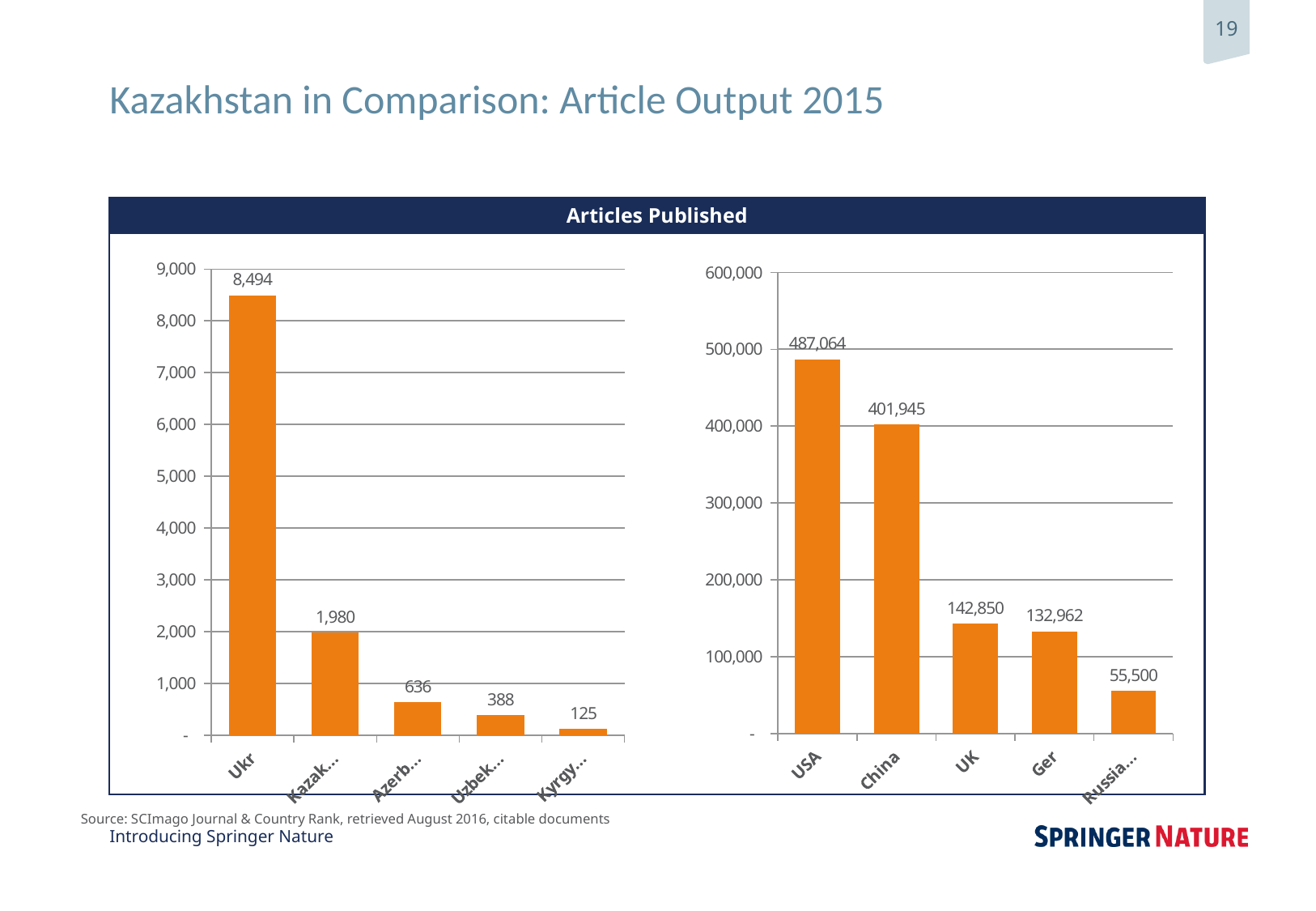
In the right chart, what is the value for China? 401,945 In the right chart, do the values rise or fall from left to right? Fall In the right chart, what is the value for Ger? 132,962 In the right chart, what is the difference between the values for USA and China? 85,119 In the left chart, what is the value for Ukr? 8,494 In the right chart, what is the difference between the values for UK and Ger? 9,888 In the left chart, which category has the lowest value? Kyrgy... (the last bar) In the left chart, is the value for the second bar (Kazak...) greater or less than 3,000? less What type of chart is used on this slide? Bar chart In the right chart, which country has the highest value? USA In the right chart, which is larger, the value for UK or the value for Ger? UK How many bars are shown in the right chart? 5